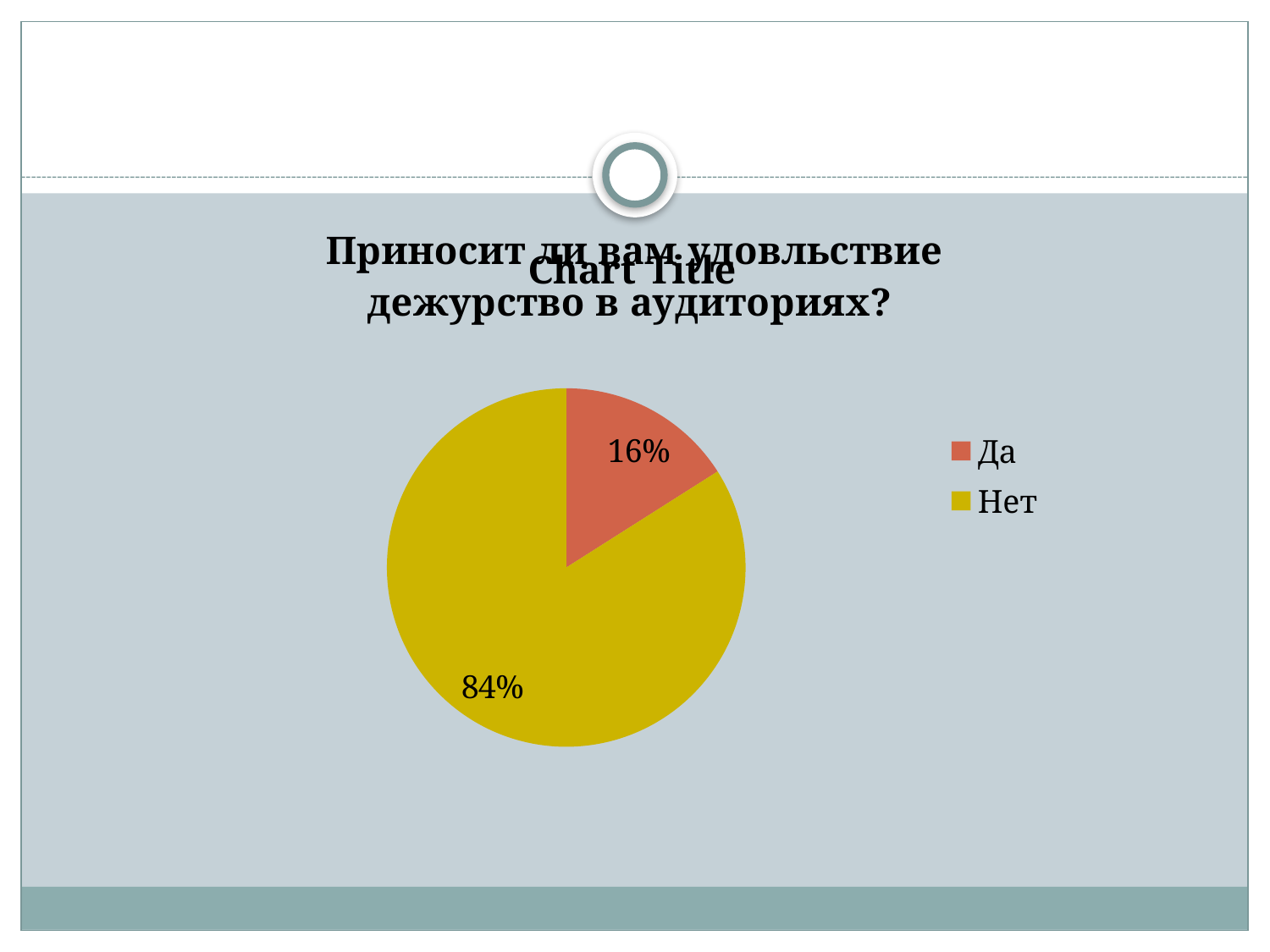
How many entries does the legend list? 2 What percentage of the pie is labelled for "Да"? 16% What colour is the slice for "Да"? orange-red What is the difference in percentage points between the "Нет" share and the "Да" share? 68 What percentage of the pie is labelled for "Нет"? 84% Which category has the largest share of the pie? Нет How many slices does the pie chart have? 2 What kind of chart is shown on the slide? pie chart Which category has the smallest share of the pie? Да Which is larger, the share for "Да" or the share for "Нет"? Нет What colour is the slice for "Нет"? yellow